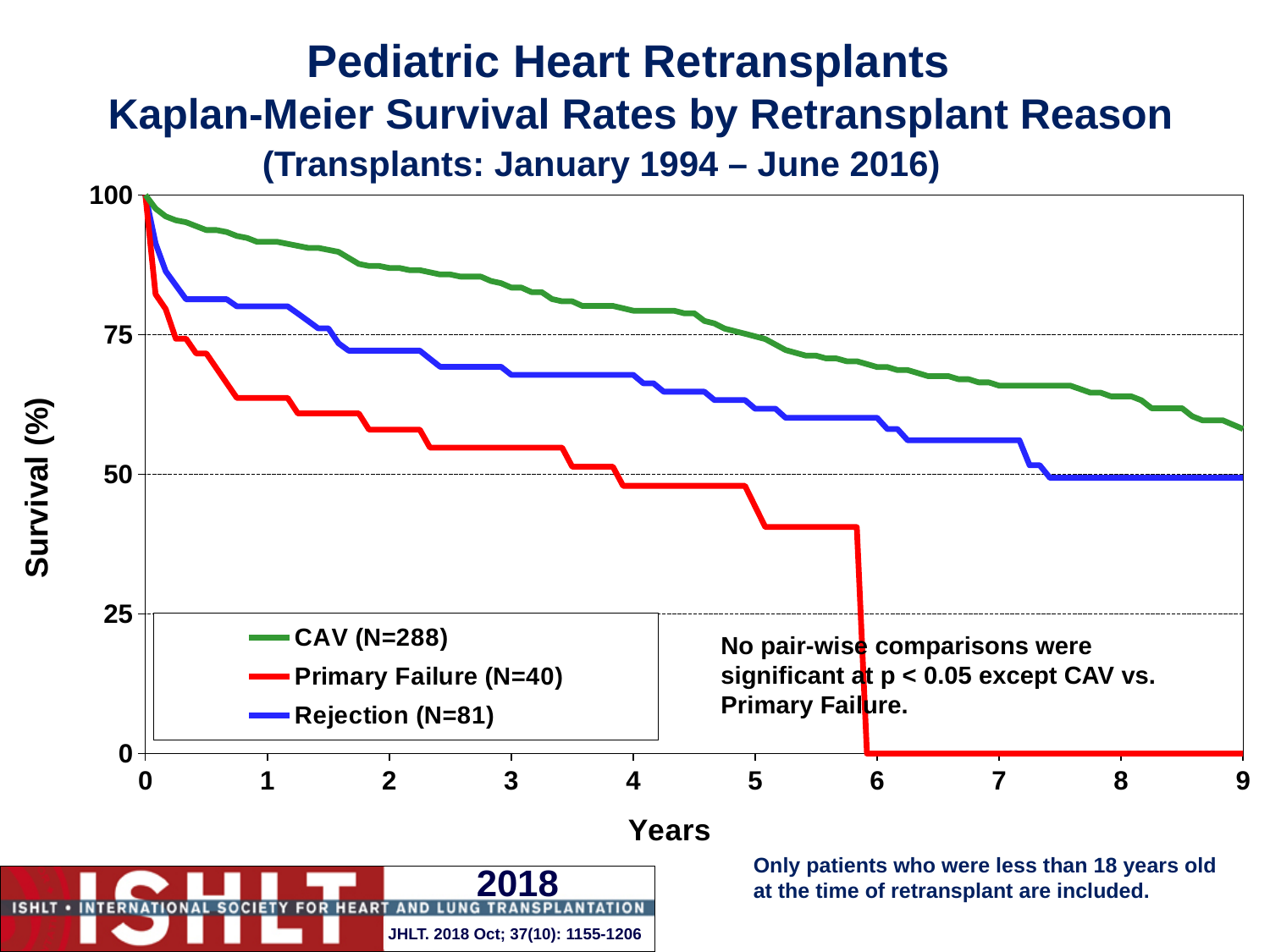
At 2 years, which series has higher survival, Rejection or Primary Failure? Rejection Is the survival for CAV at 1 year greater or less than 75? greater Which series has the lowest survival at 5 years? Primary Failure (N=40) Which series has the highest survival at 8 years? CAV (N=288) At 4 years, which series has higher survival, CAV or Rejection? CAV Do the survival curves rise or fall as years increase? Fall What kind of chart is shown on the slide? Line chart How many series does the legend list? 3 Is the survival for Rejection at 4 years greater or less than 75? less What is the N for the Rejection group shown in the legend? 81 Is the survival for CAV at 9 years greater or less than 50? greater